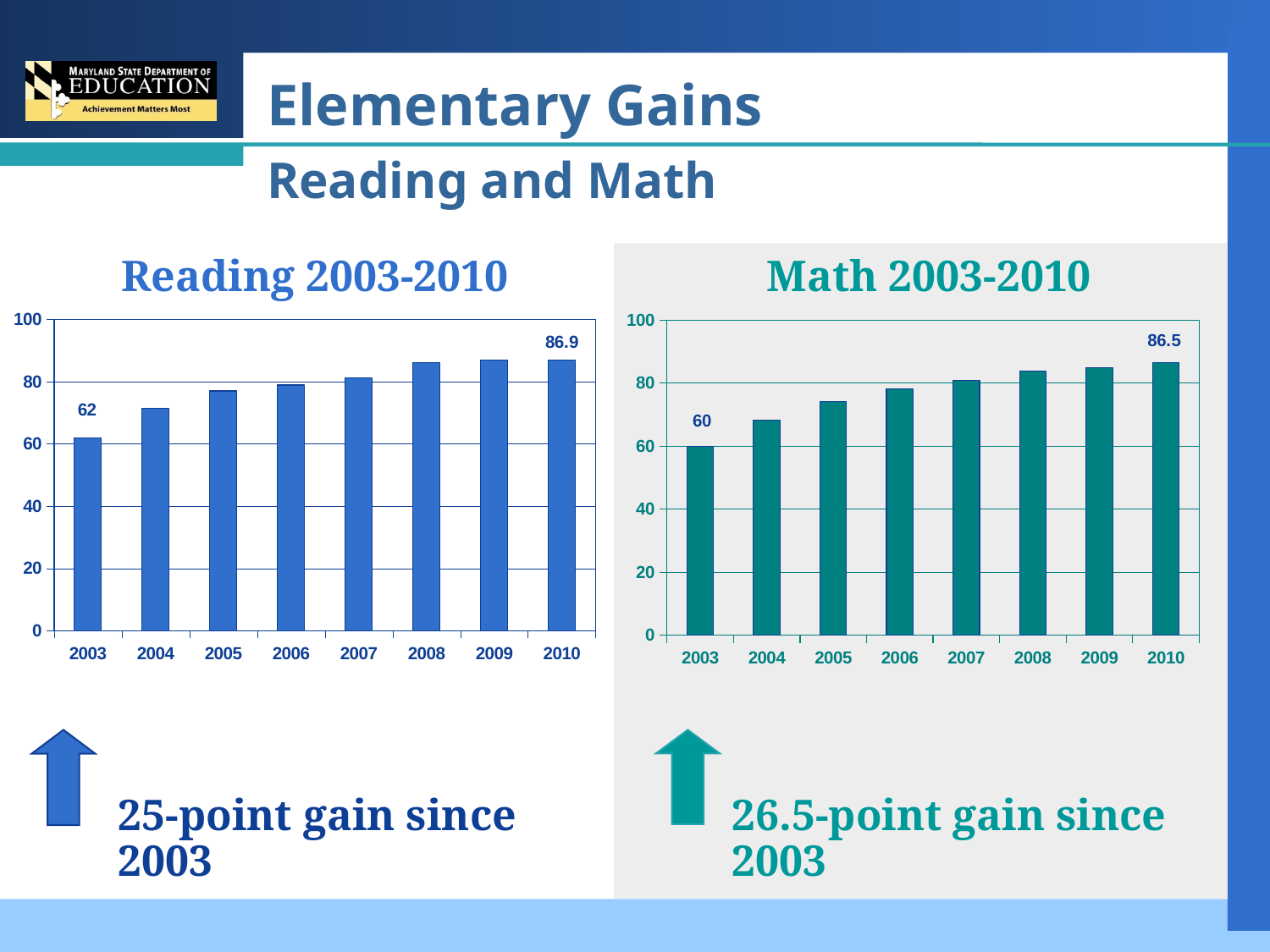
In the Reading 2003-2010 chart, what is the difference between the 2010 value and the 2003 value? 24.9 In the Math 2003-2010 chart, what is the value for 2003? 60 In the Reading 2003-2010 chart, which year has the lowest value? 2003 In the Math 2003-2010 chart, which year has the highest value? 2010 In the Reading 2003-2010 chart, is the value for 2008 greater or less than 80? greater In the Reading 2003-2010 chart, what is the value for 2003? 62 In the Reading 2003-2010 chart, what is the value for 2010? 86.9 In the Math 2003-2010 chart, what is the value for 2010? 86.5 How many years are shown on the x axis of the Math 2003-2010 chart? 8 In the Math 2003-2010 chart, is the value for 2005 greater or less than 80? less Do the values in the Reading 2003-2010 chart rise or fall from 2003 to 2010? rise In the Math 2003-2010 chart, what is the difference between the 2010 value and the 2003 value? 26.5